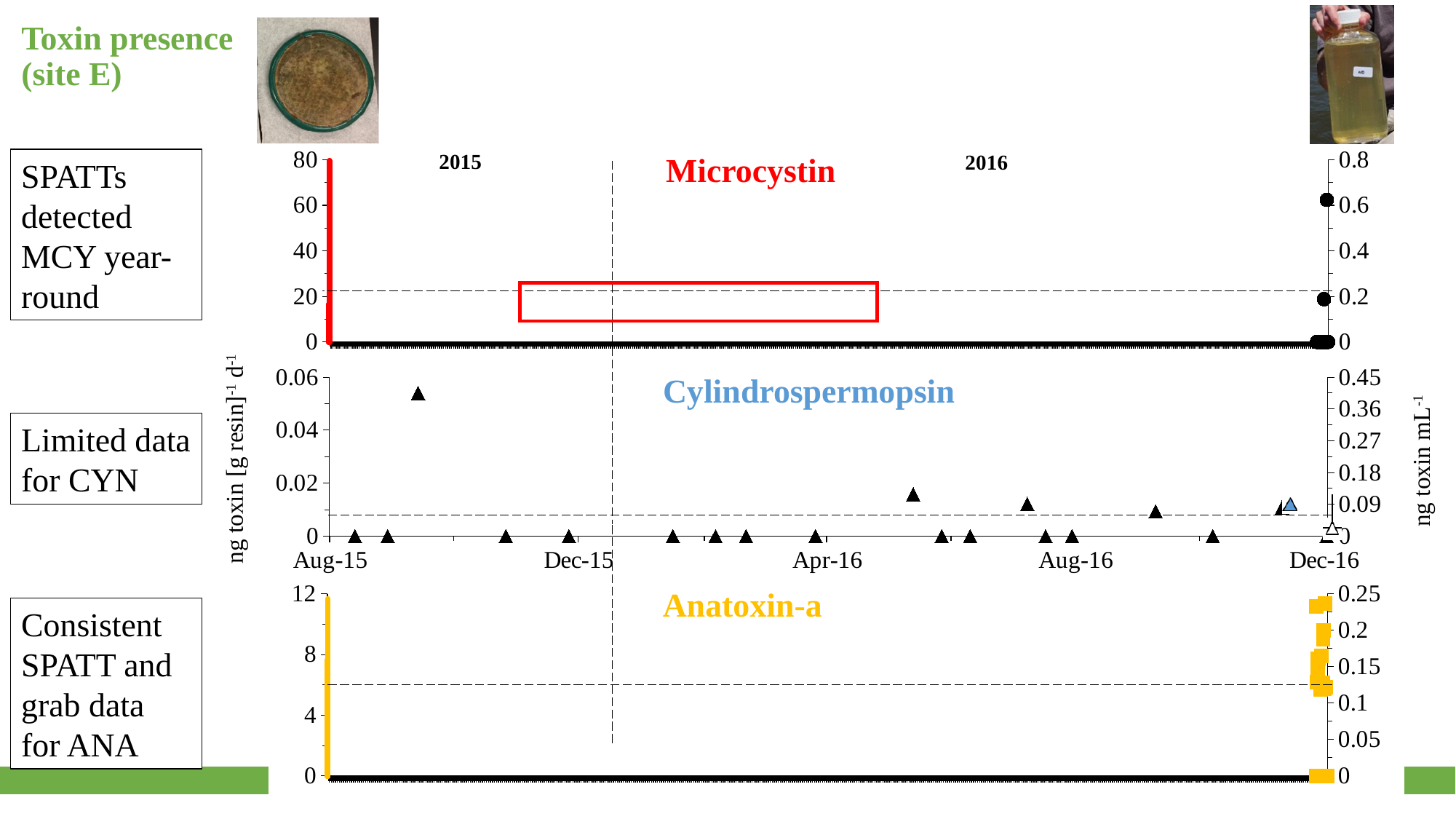
In the Anatoxin-a chart, is the highest yellow marker near Dec-16 greater or less than 0.2 on the right axis? greater What is the first x-axis label shown on the Cylindrospermopsin chart? Aug-15 What is the maximum value shown on the right axis of the Anatoxin-a chart? 0.25 In the Cylindrospermopsin chart, is the highest point greater or less than 0.04 on the left axis? greater What is the last x-axis label shown on the Cylindrospermopsin chart? Dec-16 In the Cylindrospermopsin chart, is the point near May-16 greater or less than 0.02 on the left axis? less What is the maximum value shown on the left axis of the Microcystin chart? 80 In the Cylindrospermopsin chart, is the highest point in 2015 higher or lower than the highest point in 2016? higher In the Cylindrospermopsin chart, in which year does the highest point occur? 2015 What kind of chart is the Cylindrospermopsin chart? scatter chart